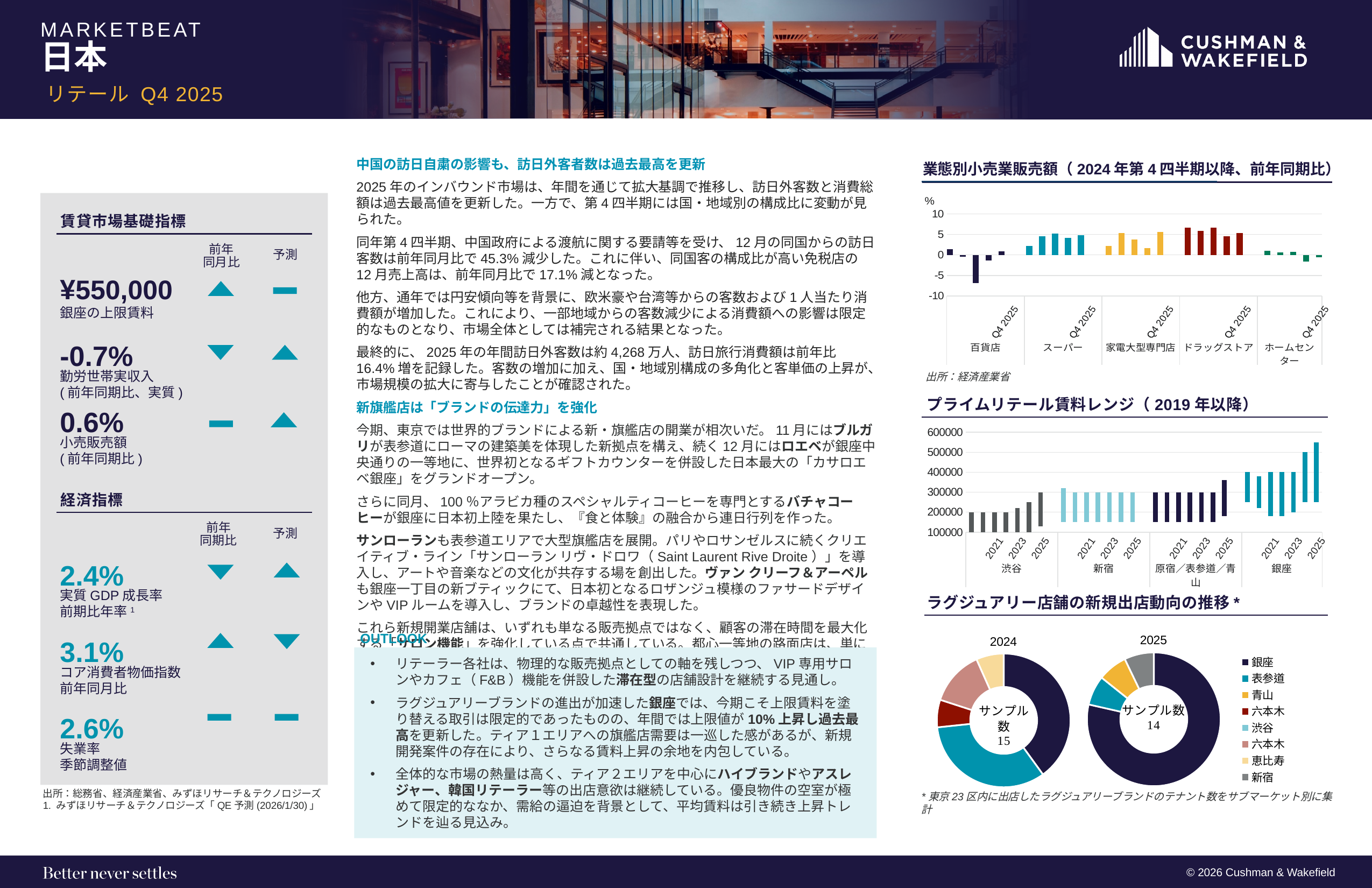
In the chart titled プライムリテール賃料レンジ, how many submarkets are shown on the x axis? 4 In the chart titled ラグジュアリー店舗の新規出店動向の推移, how many entries does the legend list? 8 In the chart titled ラグジュアリー店舗の新規出店動向の推移, what is the sample count (サンプル数) for 2024? 15 In the chart titled 業態別小売業販売額, which category has the tallest bar? ドラッグストア In the chart titled 業態別小売業販売額, are the values for ホームセンター greater or less than 5? less In the chart titled 業態別小売業販売額, how many retail categories are shown on the x axis? 5 In the chart titled ラグジュアリー店舗の新規出店動向の推移, what is the sample count (サンプル数) for 2025? 14 In the chart titled 業態別小売業販売額, what kind of chart is it? bar chart In the chart titled プライムリテール賃料レンジ, which submarket reaches the highest rent level? 銀座 In the chart titled 業態別小売業販売額, what is the source cited below the chart? 経済産業省 In the chart titled プライムリテール賃料レンジ, is the top of the 2025 bar for 銀座 greater or less than 500000? greater In the chart titled プライムリテール賃料レンジ, are the values for 渋谷 greater or less than 400000? less